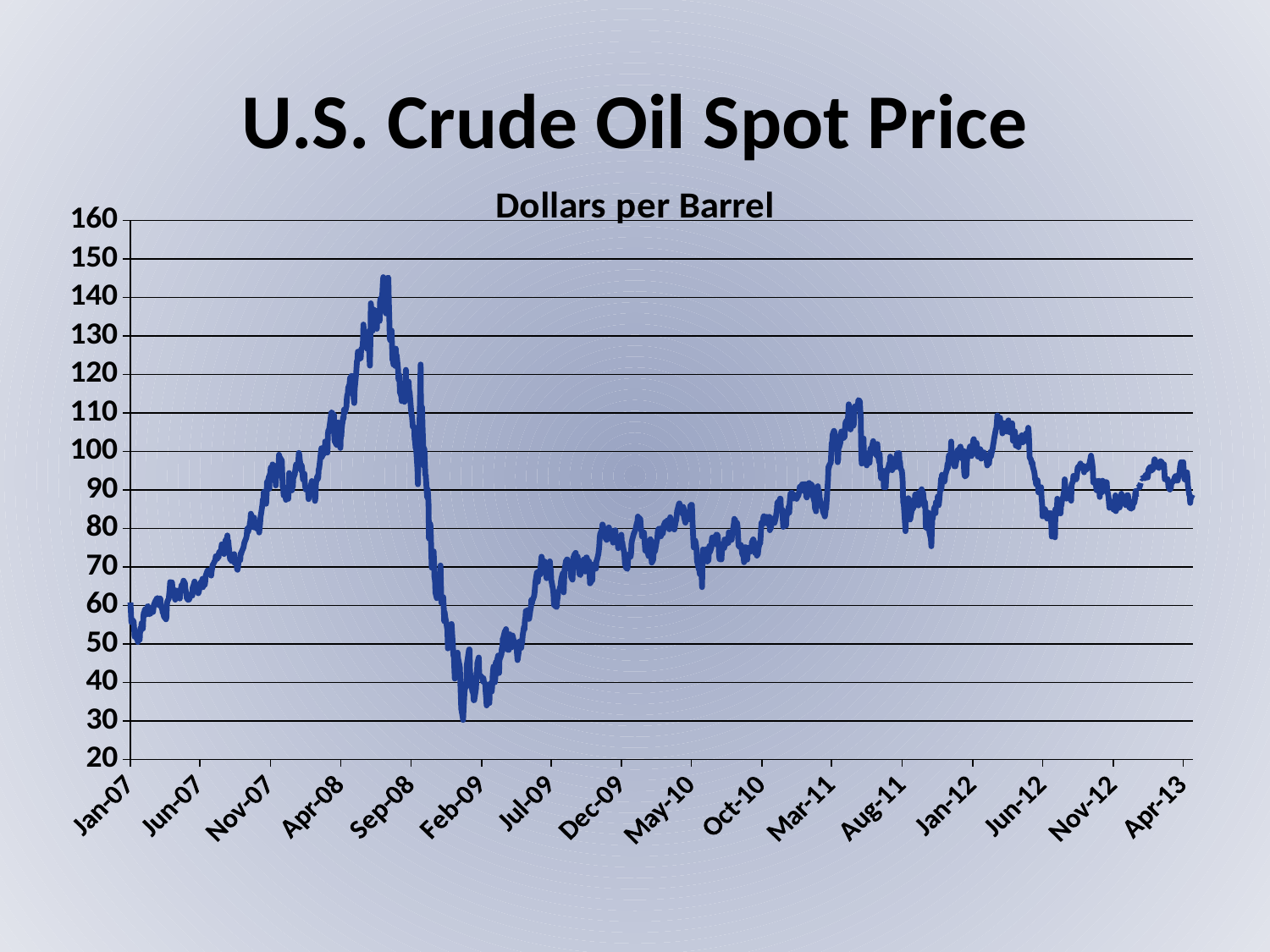
What unit is the price measured in, according to the chart subtitle? Dollars per Barrel How many lines are plotted on the chart? 1 Is the lowest value reached by the line greater or less than 40? less Is the highest value reached by the line greater or less than 140? greater How many date labels are shown along the x axis? 16 What kind of chart is shown on the slide? Line chart Does the price rise or fall between Jan-07 and Apr-08? rise Is the value at Mar-11 greater or less than 80? greater What is the title of the chart? U.S. Crude Oil Spot Price Does the price rise or fall between Sep-08 and Feb-09? fall